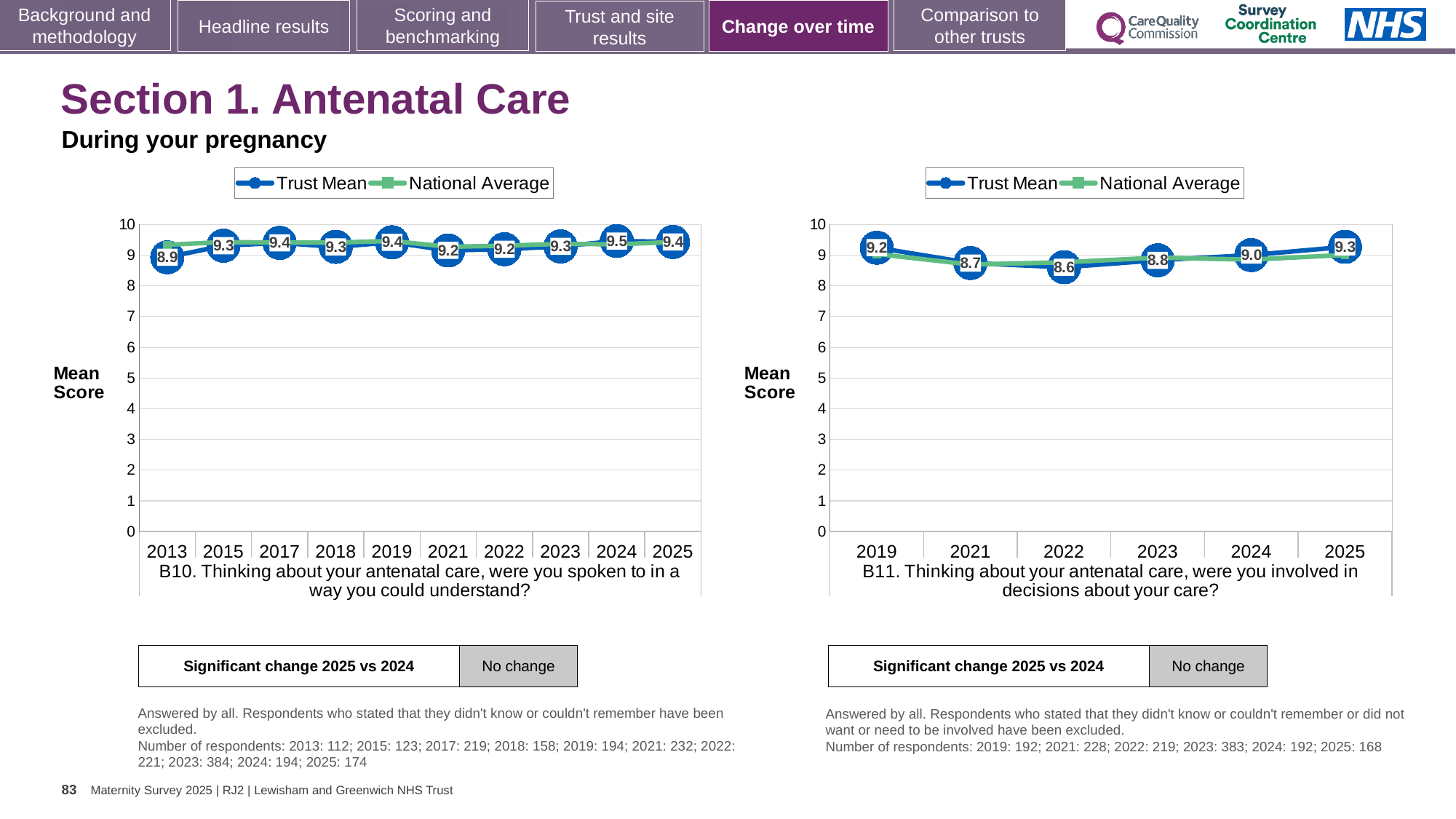
What type of chart is the B10 chart? Line chart In the B10 chart, what is the difference between the Trust Mean in 2024 and in 2013? 0.6 In the B10 chart, what is the Trust Mean for 2024? 9.5 In the B10 chart, which year has the highest Trust Mean? 2024 In the B11 chart, what is the Trust Mean for 2022? 8.6 In the B11 chart, what is the difference between the Trust Mean in 2025 and in 2022? 0.7 In the B10 chart, what is the Trust Mean for 2013? 8.9 In the B10 chart, which year has the lowest Trust Mean? 2013 How many series does the legend of the B11 chart list? 2 In the B11 chart, which year has the highest Trust Mean? 2025 In the B10 chart, how many years are shown on the x axis? 10 In the B11 chart, is the Trust Mean higher in 2019 or in 2021? 2019